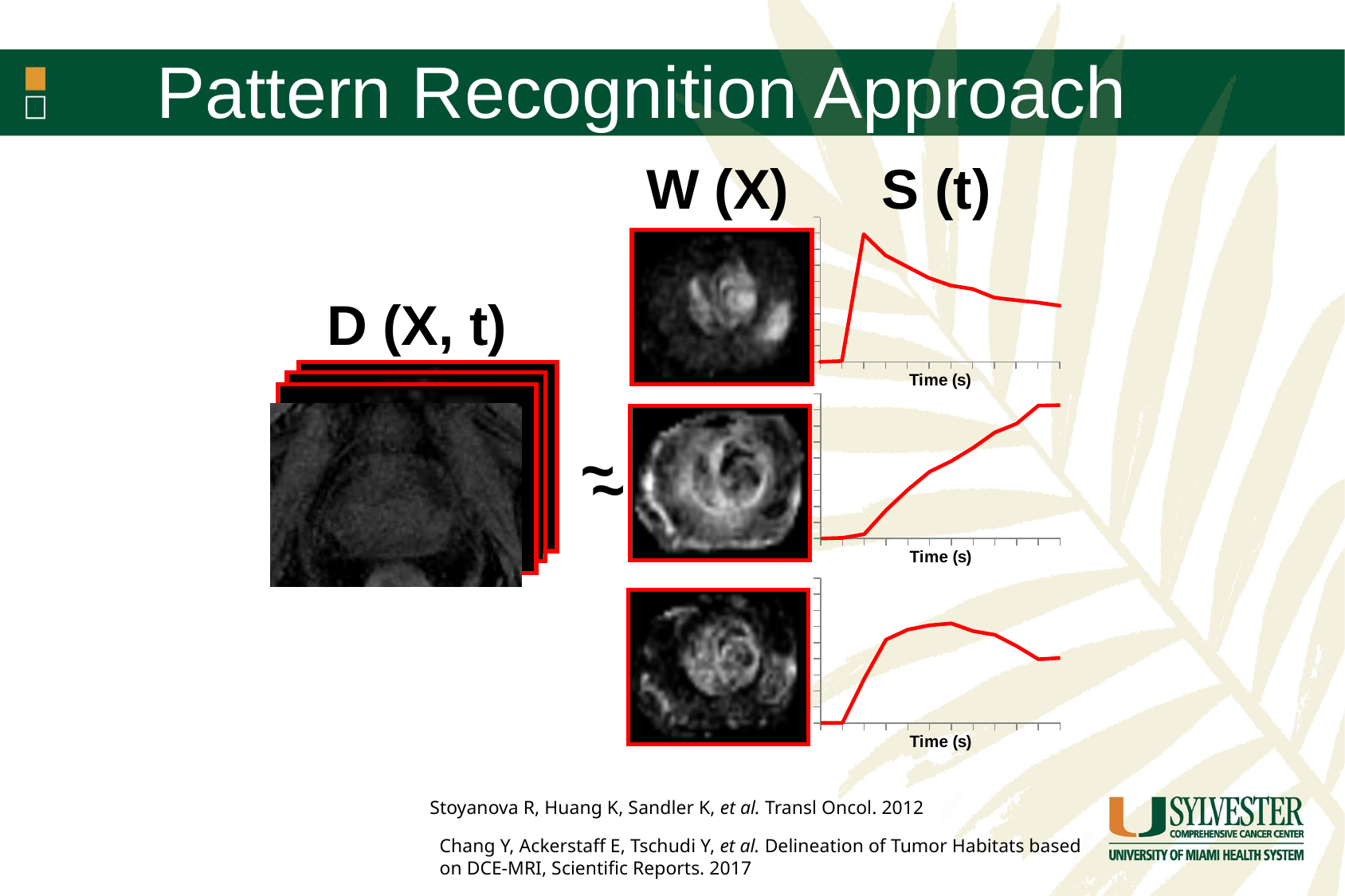
Which S (t) chart ends at its highest value at the right end of the x axis: the top, middle, or bottom chart? middle What kind of chart is the top S (t) chart on the slide? line chart How many S (t) line charts are shown on the slide? 3 How many lines are plotted in each S (t) chart? 1 In the middle S (t) chart, does the line rise or fall overall along the x axis? rise In the top S (t) chart, after its sharp initial rise, does the line rise or fall along the rest of the x axis? fall What is the x-axis label of the S (t) charts? Time (s) What colour are the lines in the S (t) charts? red